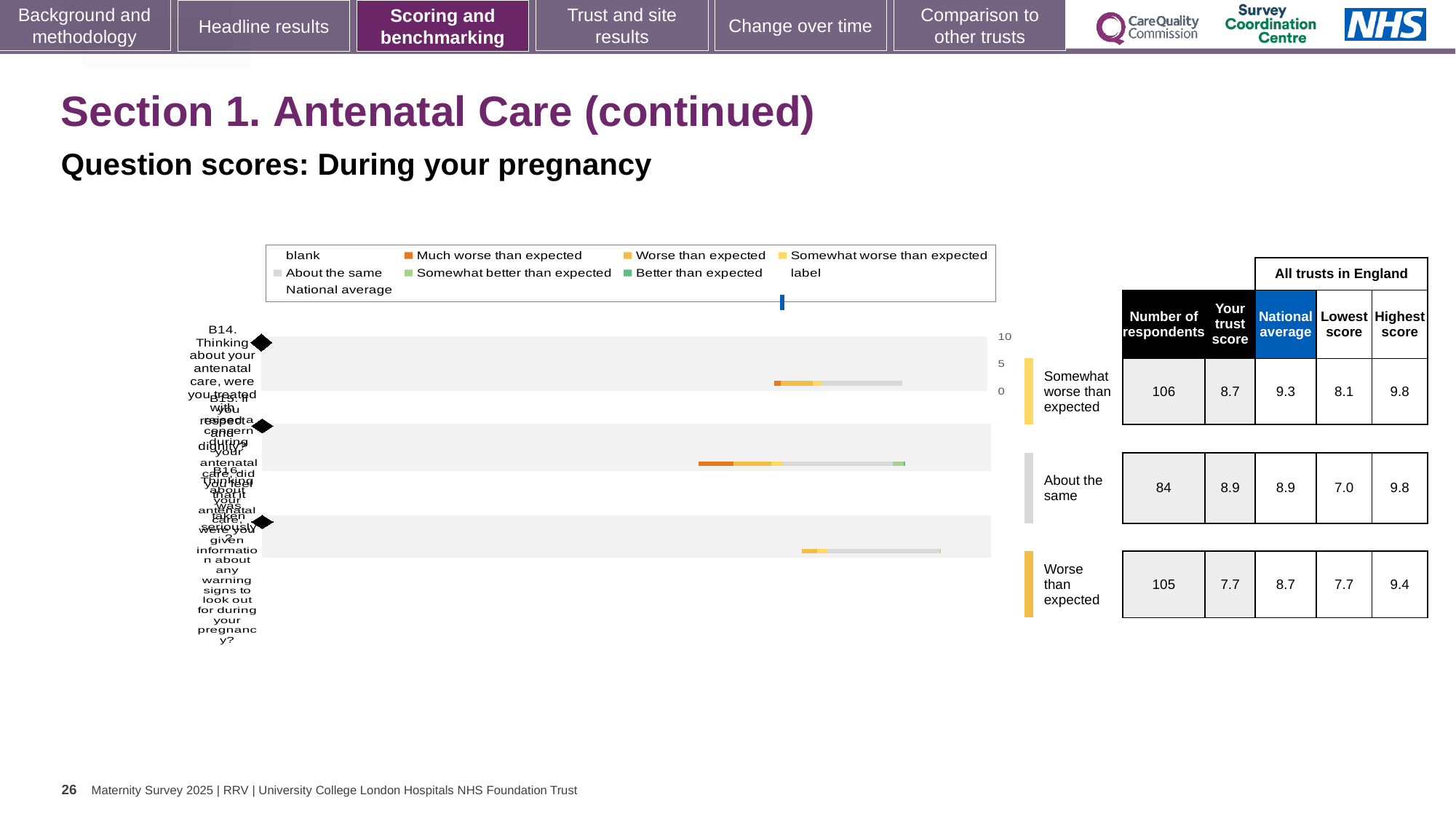
In the table beside the chart, what is the number of respondents for the row rated 'Somewhat worse than expected'? 106 In the table beside the chart, what is the trust score for the row rated 'About the same'? 8.9 In the table beside the chart, is the trust score for the 'Worse than expected' row larger or smaller than the trust score for the 'About the same' row? smaller In the table beside the chart, what is the national average for the row rated 'Worse than expected'? 8.7 How many question bars are plotted in the chart? 3 Which legend entry is shown in orange, immediately after 'blank'? Much worse than expected What kind of chart is shown on the slide? bar chart In the table beside the chart, what is the lowest score for the 'About the same' row? 7.0 In the table beside the chart, which row has the lowest trust score? Worse than expected In the table beside the chart, what is the difference between the national average and the trust score for the 'Somewhat worse than expected' row? 0.6 In the table beside the chart, which row has the highest number of respondents? Somewhat worse than expected What is the highest value shown on the chart's axis? 10